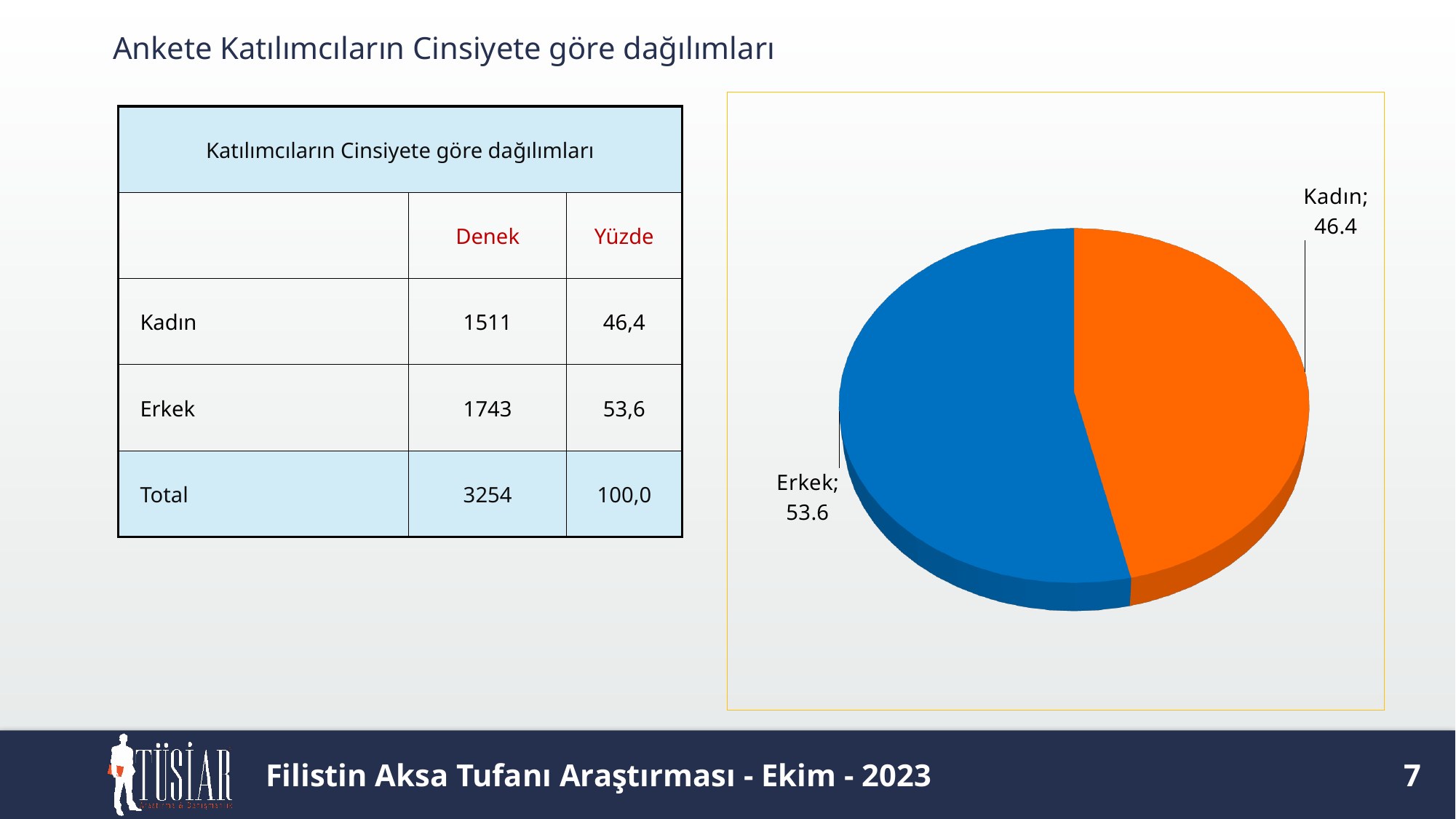
What is the difference between the Erkek and Kadın values in the pie chart? 7.2 What is the value shown for Kadın in the pie chart? 46.4 What colour is the Erkek slice in the pie chart? blue What is the value shown for Erkek in the pie chart? 53.6 What colour is the Kadın slice in the pie chart? orange What is the total of the two slice values shown in the pie chart? 100 Which slice of the pie chart is the largest? Erkek Which is larger in the pie chart, Erkek or Kadın? Erkek How many slices does the pie chart have? 2 Which slice of the pie chart is the smallest? Kadın What kind of chart is shown on the slide? pie chart